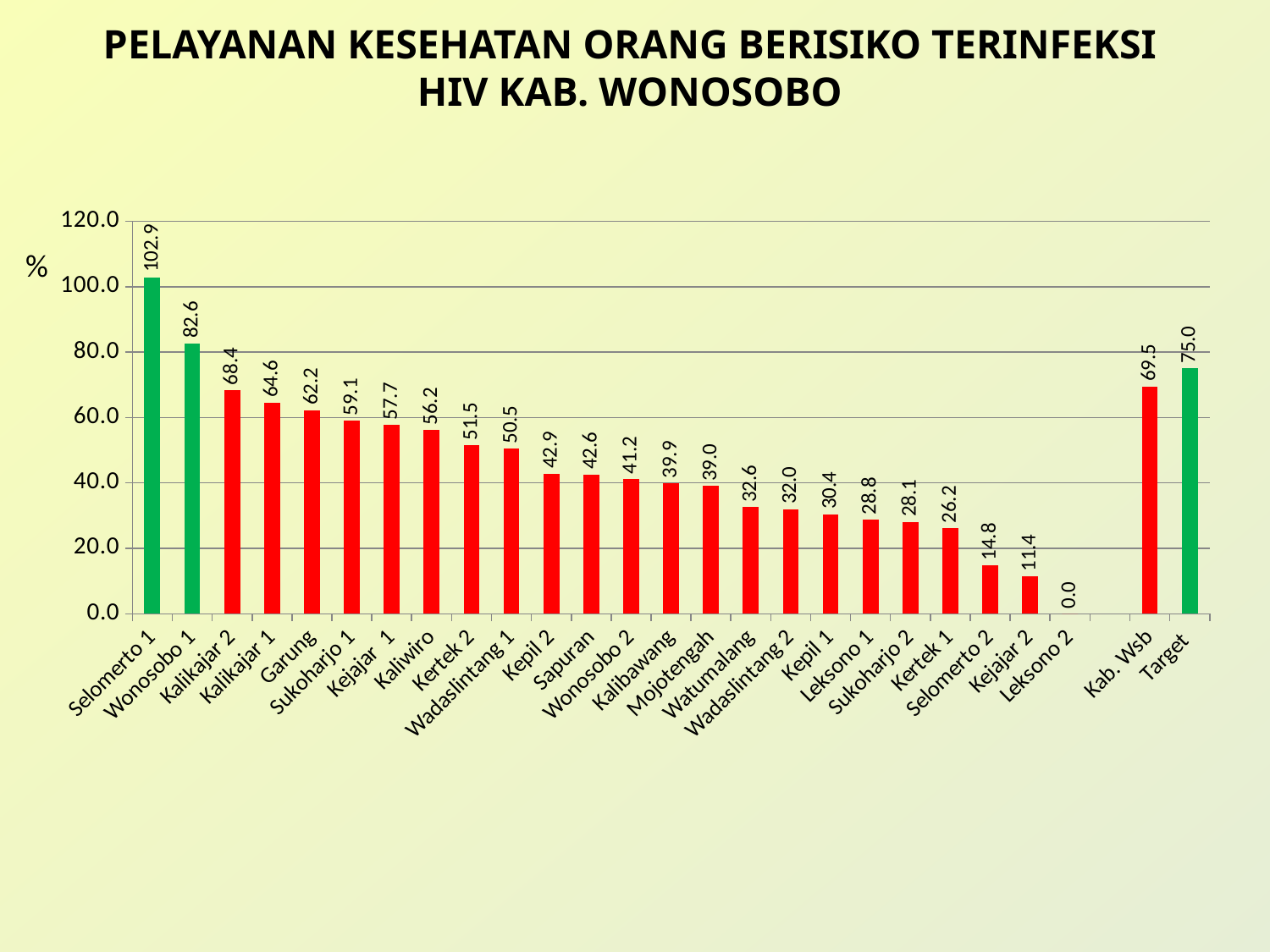
How many categories are shown on the x axis? 26 What is the difference between the values for Target and Kab. Wsb? 5.5 What is the value for Kab. Wsb? 69.5 What is the value shown for Target? 75.0 Is the value for Kertek 1 greater or less than 40.0? less Which is larger, the value for Wonosobo 1 or the value for Kalikajar 2? Wonosobo 1 What is the title of the chart? PELAYANAN KESEHATAN ORANG BERISIKO TERINFEKSI HIV KAB. WONOSOBO Which category has the highest value? Selomerto 1 Which category has the lowest value? Leksono 2 What is the value for Mojotengah? 39.0 What is the value for Selomerto 1? 102.9 What type of chart is shown on the slide? bar chart